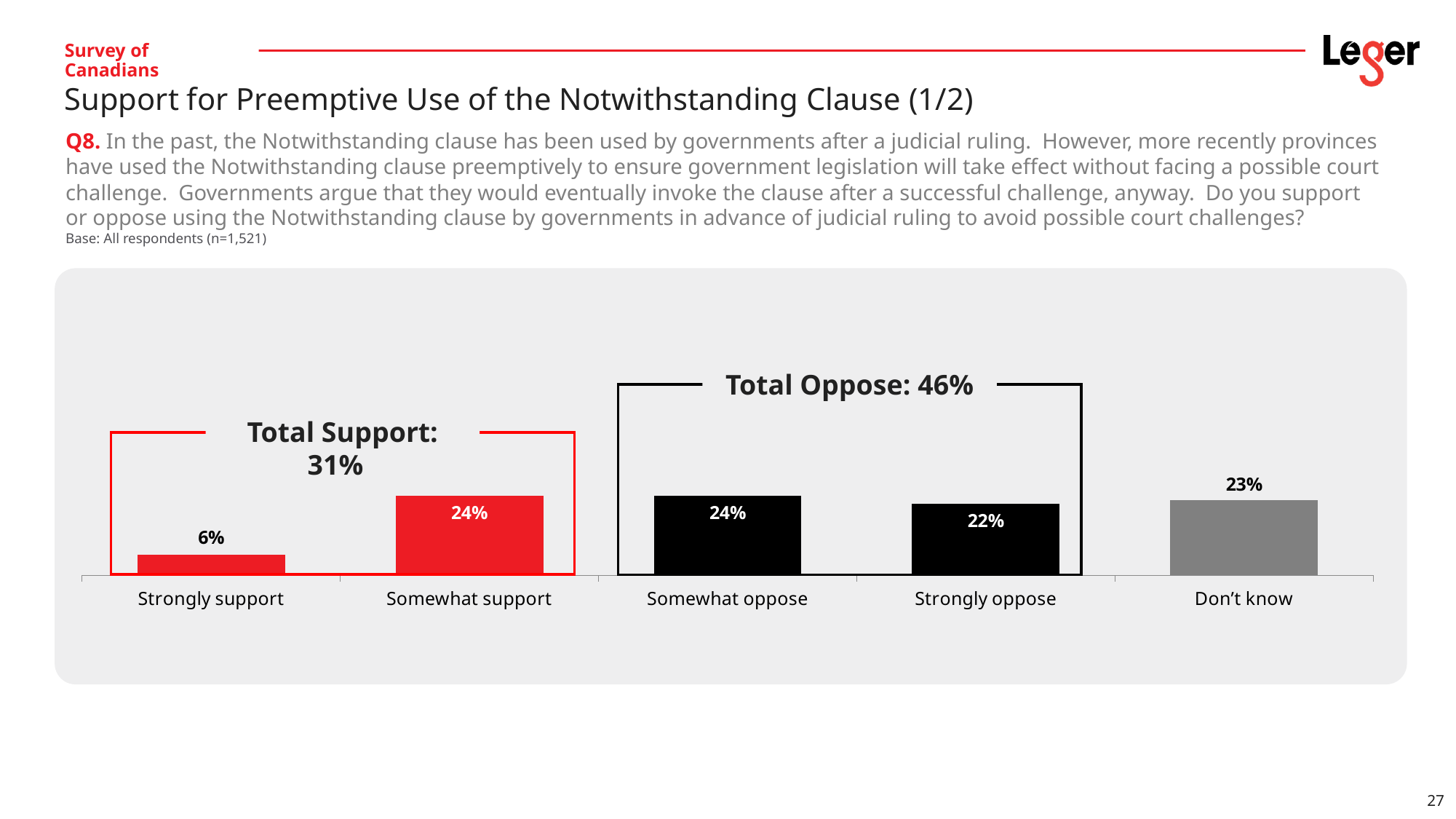
What percentage of respondents strongly support the preemptive use of the Notwithstanding clause? 6% What is the difference between the 'Don't know' and 'Strongly oppose' values? 1% What percentage of respondents strongly oppose the preemptive use of the Notwithstanding clause? 22% What is the difference between the 'Somewhat support' and 'Strongly support' values? 18% What kind of chart is shown on the slide? Bar chart What is the Total Support percentage shown on the chart? 31% What percentage of respondents answered 'Don't know'? 23% Which is larger, the value for 'Strongly oppose' or the value for 'Don't know'? Don't know How many response categories are shown on the chart? 5 Which response category has the lowest value? Strongly support What is the Total Oppose percentage shown on the chart? 46% What percentage of respondents somewhat support the preemptive use of the Notwithstanding clause? 24%